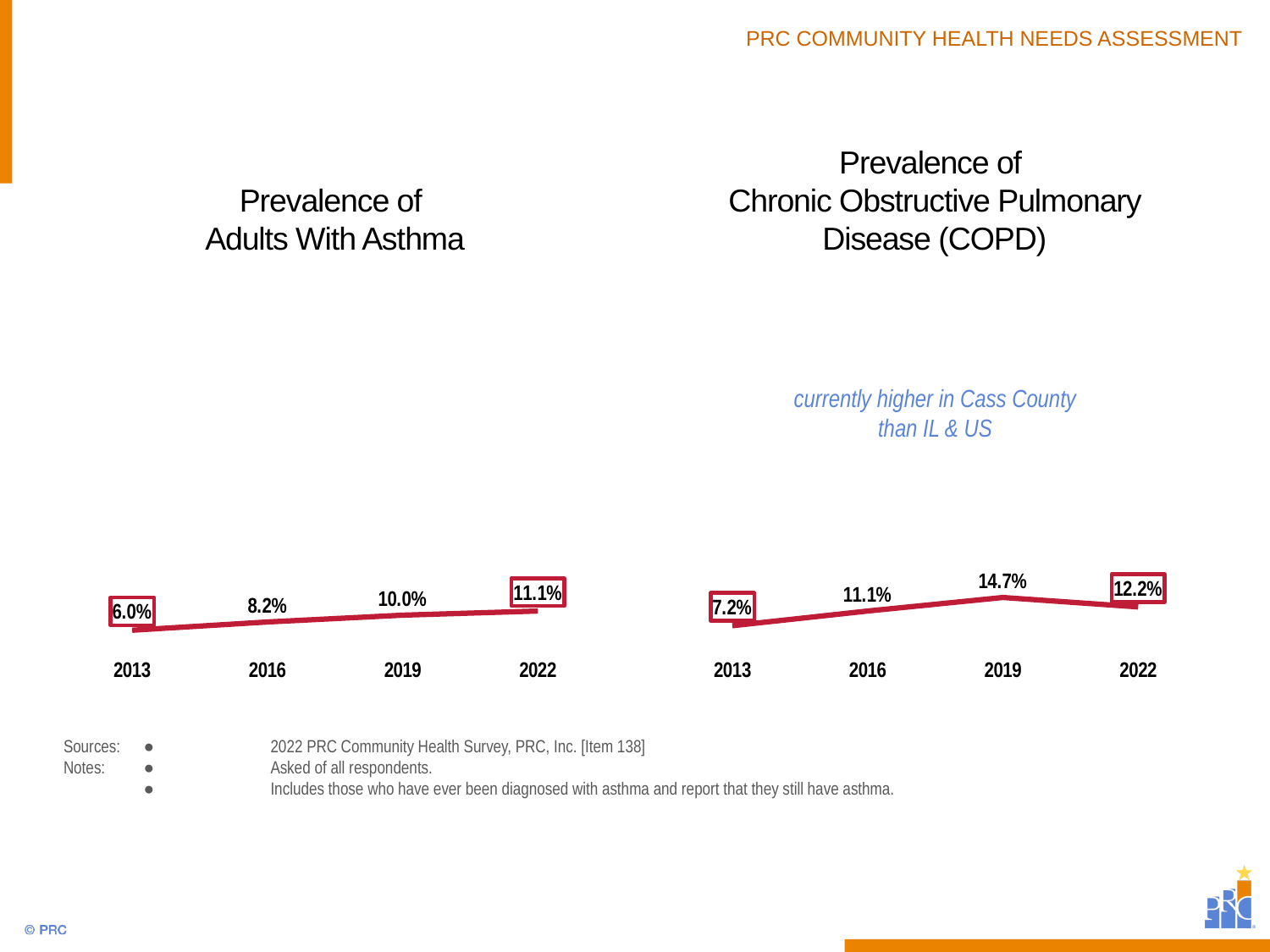
In the Prevalence of Adults With Asthma chart, which year has the lowest value? 2013 In the Prevalence of Adults With Asthma chart, what is the value for 2013? 6.0% In the Prevalence of Adults With Asthma chart, what is the value for 2022? 11.1% In the Prevalence of Chronic Obstructive Pulmonary Disease (COPD) chart, what is the difference between the 2019 and 2022 values? 2.5% In the Prevalence of Adults With Asthma chart, what is the difference between the 2022 and 2013 values? 5.1% In the Prevalence of Adults With Asthma chart, do the values rise or fall from 2013 to 2022? Rise How many years are plotted in the Prevalence of Adults With Asthma chart? 4 Which is larger: the 2016 value in the Prevalence of Adults With Asthma chart or the 2016 value in the Prevalence of COPD chart? COPD (11.1%) In the Prevalence of Chronic Obstructive Pulmonary Disease (COPD) chart, what is the value for 2019? 14.7% In the Prevalence of Chronic Obstructive Pulmonary Disease (COPD) chart, what is the value for 2022? 12.2% In the Prevalence of Chronic Obstructive Pulmonary Disease (COPD) chart, which year has the highest value? 2019 What kind of chart is the Prevalence of Adults With Asthma chart? Line chart